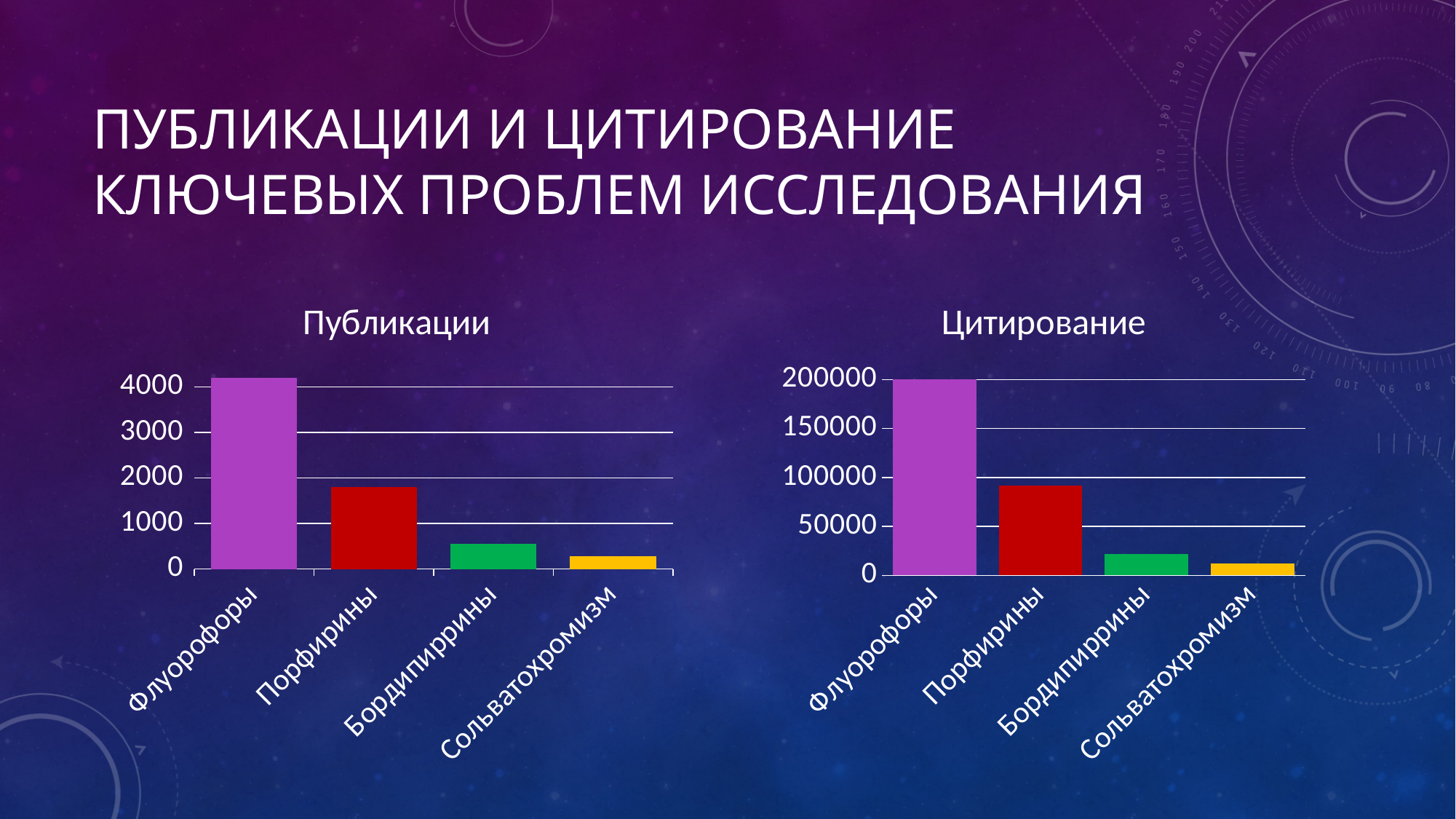
In the "Цитирование" chart, is the value for Бордипиррины greater or less than 50000? less In the "Публикации" chart, is the value for Порфирины greater or less than 2000? less In the "Публикации" chart, which category has the highest value? Флуорофоры In the "Цитирование" chart, is the value for Порфирины greater or less than 100000? less In the "Публикации" chart, which category has the lowest value? Сольватохромизм How many categories are shown in the "Публикации" chart? 4 In the "Цитирование" chart, which is larger: Порфирины or Бордипиррины? Порфирины In the "Цитирование" chart, which category has the highest value? Флуорофоры What kind of chart is the "Публикации" chart? bar chart Do the values in the "Публикации" chart rise or fall from left to right along the x axis? fall In the "Цитирование" chart, which category has the lowest value? Сольватохромизм